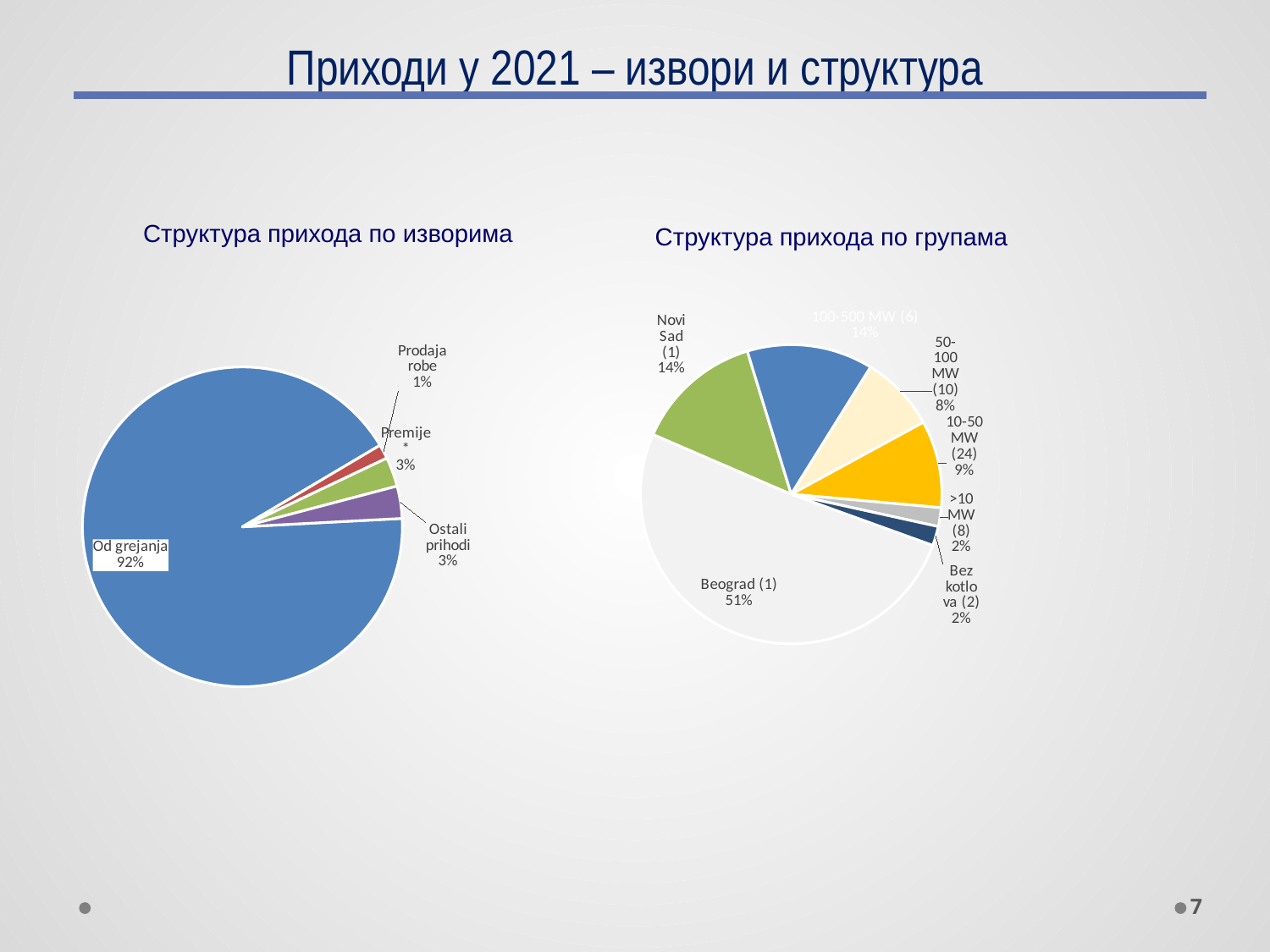
In the chart "Структура прихода по групама", what is the share for "Novi Sad (1)"? 14% How many slices does the pie chart "Структура прихода по групама" have? 7 In the chart "Структура прихода по изворима", what is the share for "Ostali prihodi"? 3% In the chart "Структура прихода по изворима", what is the share for "Prodaja robe"? 1% In the chart "Структура прихода по групама", which is larger: the share for "10-50 MW (24)" or for "50-100 MW (10)"? 10-50 MW (24) In the chart "Структура прихода по изворима", which category has the largest share? Od grejanja How many slices does the pie chart "Структура прихода по изворима" have? 4 In the chart "Структура прихода по изворима", which category has the smallest share? Prodaja robe In the chart "Структура прихода по изворима", what share of revenue comes from "Od grejanja"? 92% In the chart "Структура прихода по групама", what is the share for "Beograd (1)"? 51% What type of chart is used for "Структура прихода по изворима"? pie chart In the chart "Структура прихода по групама", which category has the largest share? Beograd (1)